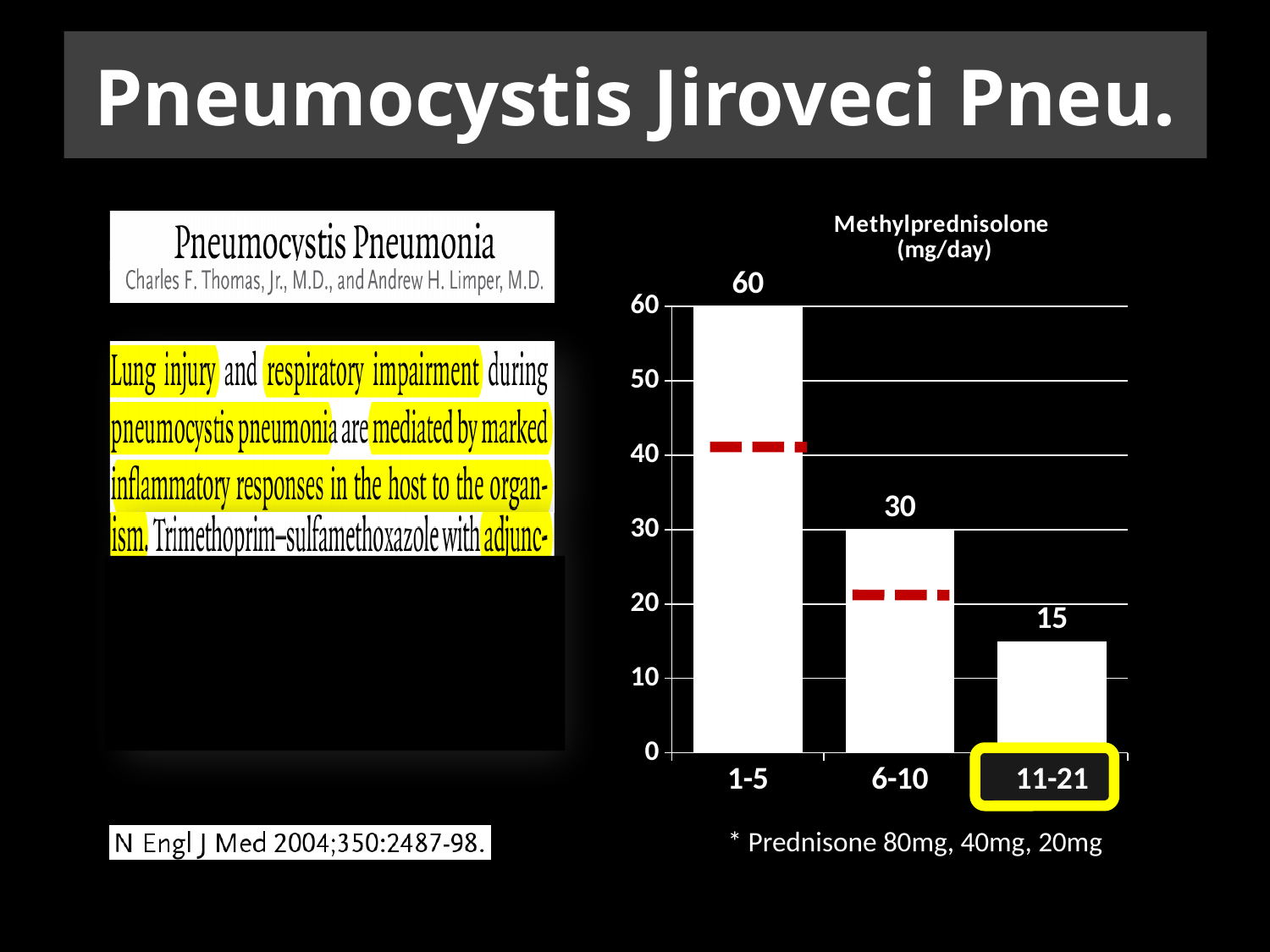
What is the methylprednisolone dose (mg/day) shown for days 6-10? 30 What is the methylprednisolone dose (mg/day) shown for days 1-5? 60 How many day-range categories are shown on the chart? 3 What is the difference between the methylprednisolone dose for days 6-10 and days 11-21? 15 Which day range has the highest methylprednisolone dose? 1-5 What kind of chart is shown on the slide? Bar chart Which is larger, the dose for days 6-10 or the dose for days 11-21? 6-10 What is the title of the chart? Methylprednisolone (mg/day) Which day range has the lowest methylprednisolone dose? 11-21 Do the methylprednisolone doses rise or fall across the day ranges from left to right? Fall What is the methylprednisolone dose (mg/day) shown for days 11-21? 15 What is the difference between the methylprednisolone dose for days 1-5 and days 6-10? 30